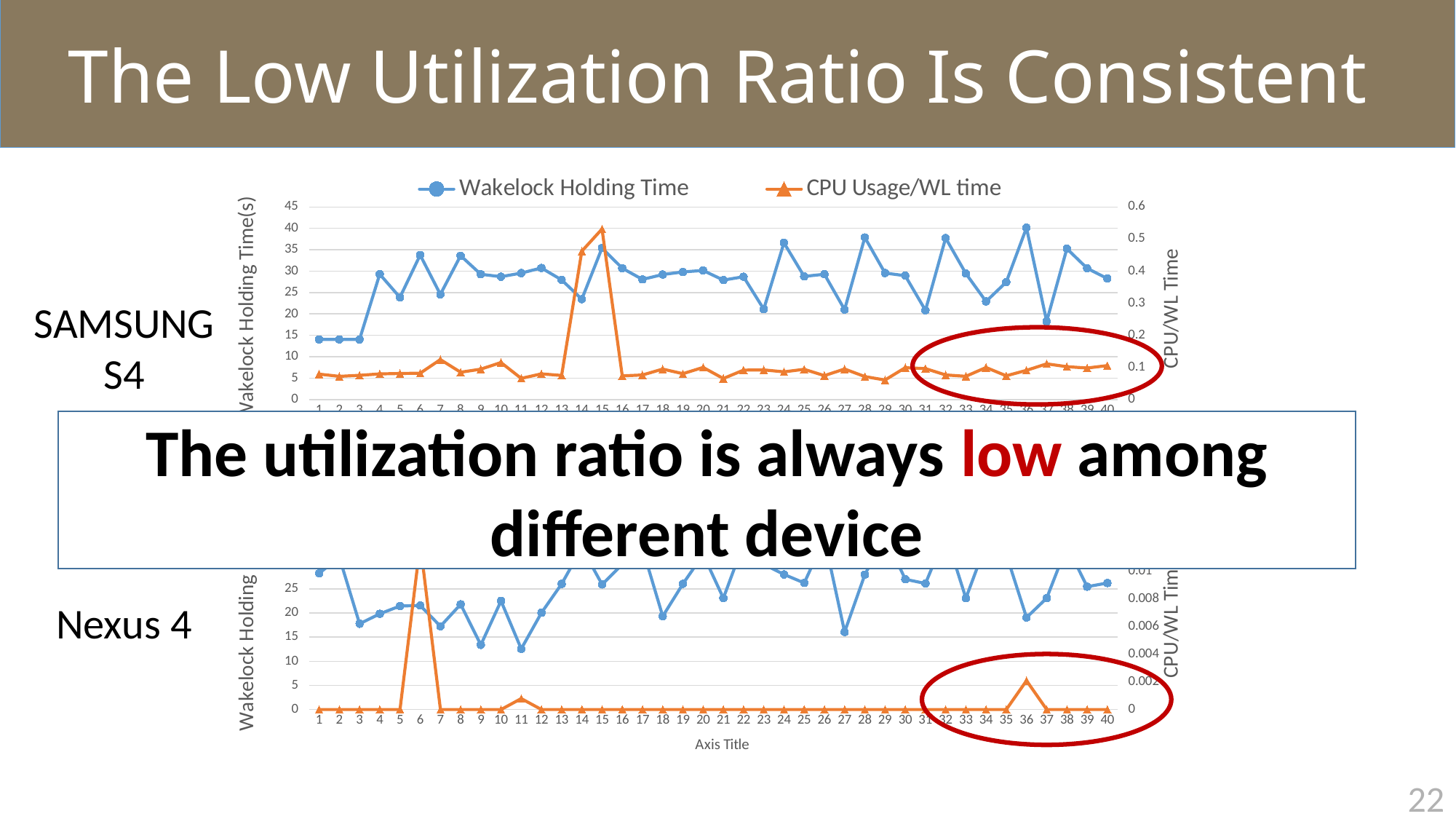
In the Nexus 4 chart, at which x-axis point does CPU Usage/WL time spike to its highest value? 6 In the SAMSUNG S4 chart, at which x-axis point does CPU Usage/WL time reach its highest value? 15 In the SAMSUNG S4 chart, is the Wakelock Holding Time at point 1 greater or less than 20? less How many points are plotted along the x axis of the Nexus 4 chart? 40 In the SAMSUNG S4 chart, at which x-axis point is Wakelock Holding Time highest? 36 How many series does the legend list for the charts on the slide? 2 In the SAMSUNG S4 chart, is the CPU Usage/WL time at point 15 greater or less than 0.4? greater In the Nexus 4 chart, is the Wakelock Holding Time at point 9 greater or less than 15? less What is the label on the right-hand vertical axis of the SAMSUNG S4 chart? CPU/WL Time In the SAMSUNG S4 chart, which has the larger Wakelock Holding Time, point 36 or point 37? point 36 What type of chart is the SAMSUNG S4 chart at the top of the slide? line chart